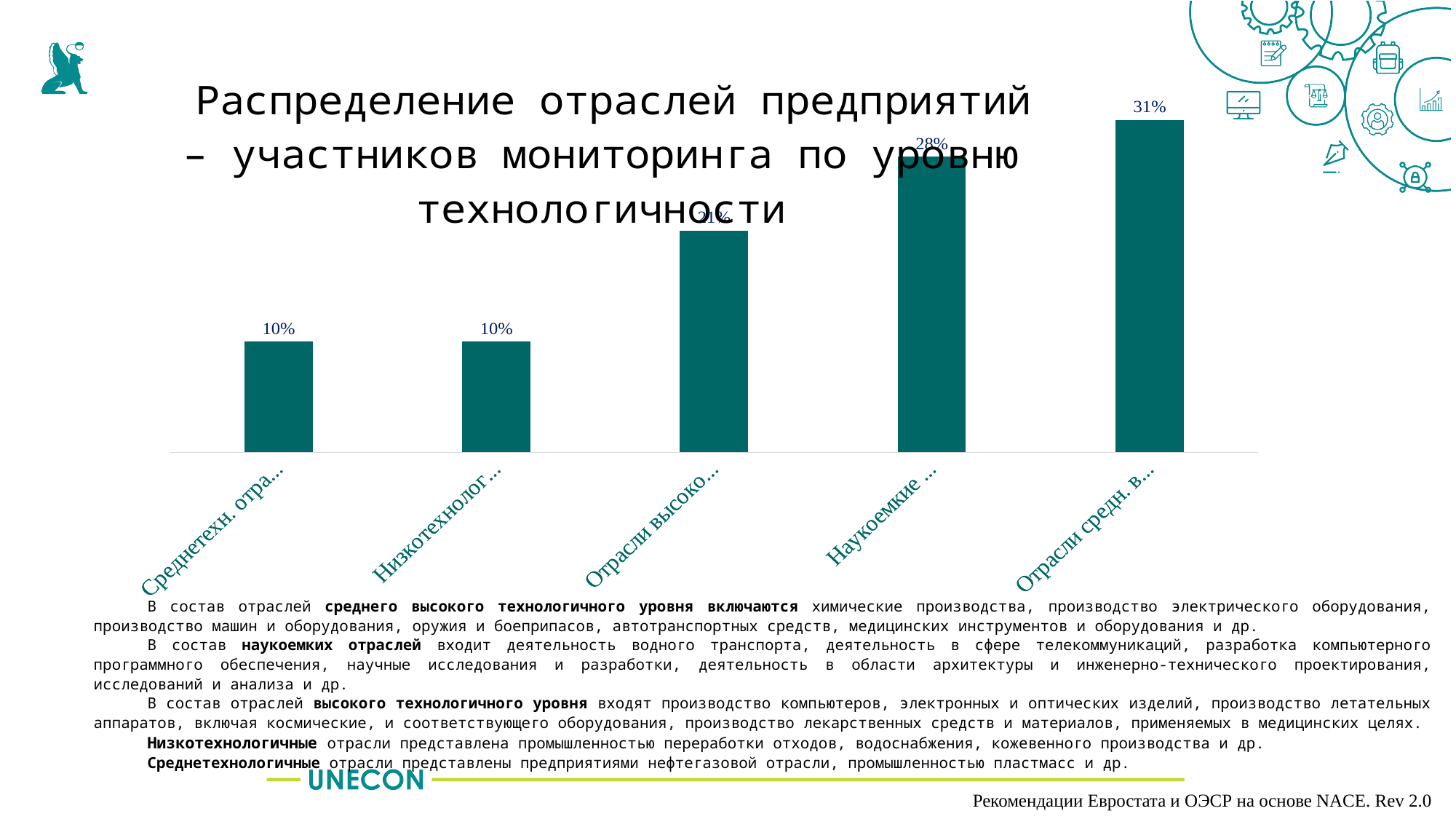
What is the value of the bar labelled "Низкотехнолог..."? 10% Which category has the highest value in the chart? Отрасли средн. в... Which is larger: the value for "Наукоемкие ..." or the value for "Отрасли средн. в..."? Отрасли средн. в... What type of chart is shown on the slide? Bar chart What is the lowest value shown in the chart? 10% How many bars (categories) does the chart show? 5 Do the bar values generally rise or fall from left to right along the x axis? Rise What is the value of the bar labelled "Наукоемкие ..."? 28% What is the value of the bar labelled "Среднетехн. отра..."? 10% What is the difference between the values for "Отрасли средн. в..." and "Наукоемкие ..."? 3 percentage points What is the difference between the values for "Наукоемкие ..." and "Низкотехнолог..."? 18 percentage points What is the value of the bar labelled "Отрасли средн. в..."? 31%